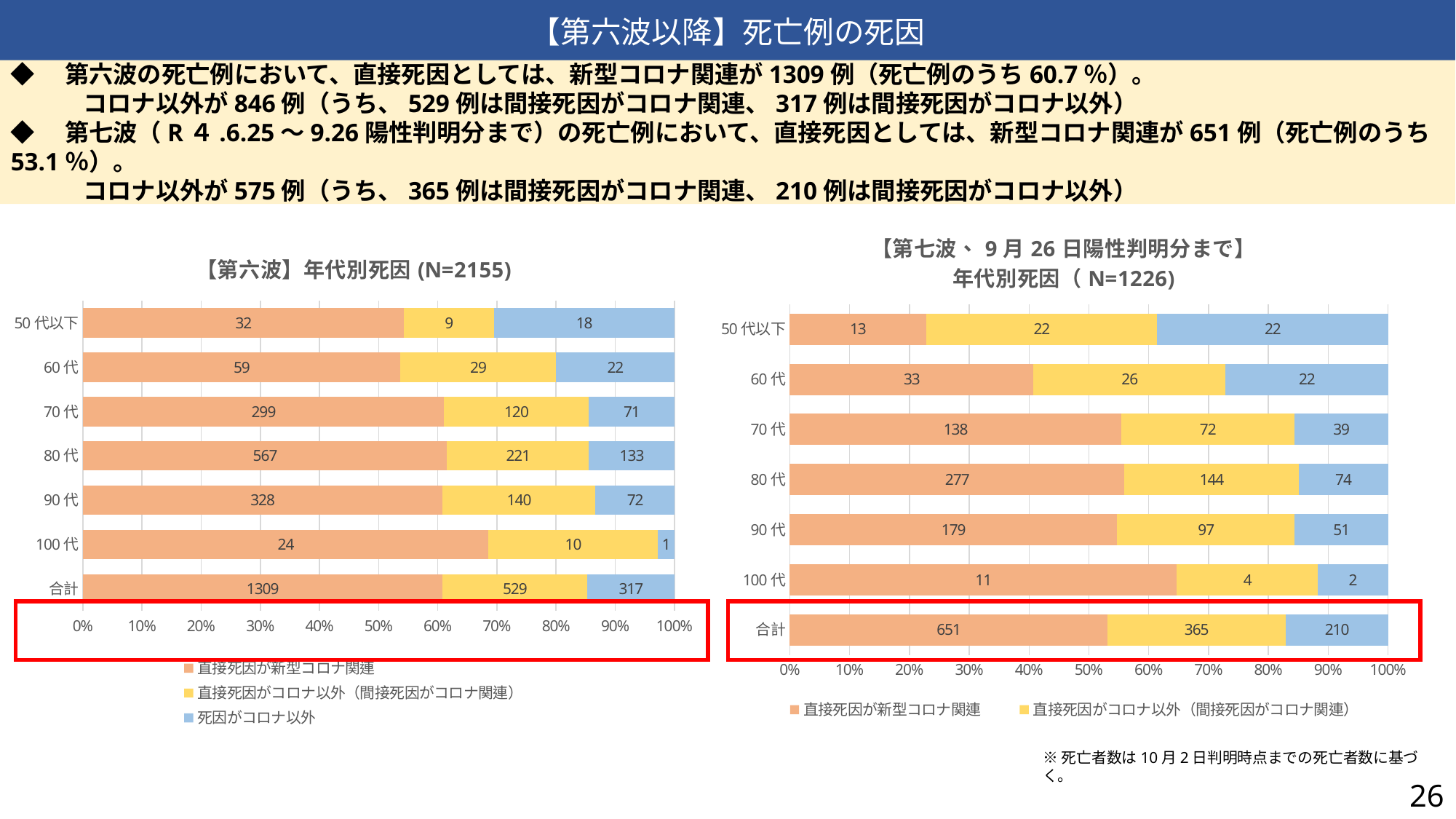
In the left chart (【第六波】年代別死因), how many series does the legend list? 3 In the left chart (【第六波】年代別死因), what is the value of 死因がコロナ以外 for 100代? 1 In the left chart (【第六波】年代別死因), which age group (excluding 合計) has the highest value for 直接死因が新型コロナ関連? 80代 In the left chart (【第六波】年代別死因), what is the value of 直接死因が新型コロナ関連 for 80代? 567 In the left chart (【第六波】年代別死因), what is the difference between the 直接死因が新型コロナ関連 values for 80代 and 90代? 239 What type of chart is the left chart (【第六波】年代別死因)? Stacked bar chart In the right chart (【第七波】年代別死因), what is the value of the middle (yellow) segment for 80代? 144 In the right chart (【第七波】年代別死因), what is the total of the three segments for the 合計 bar? 1226 In the right chart (【第七波】年代別死因), which is larger for 70代: the 直接死因が新型コロナ関連 value or the yellow segment value? 直接死因が新型コロナ関連 (138) In the right chart (【第七波】年代別死因), what is the value of 直接死因が新型コロナ関連 for 90代? 179 In the right chart (【第七波】年代別死因), which age group (excluding 合計) has the lowest value for 直接死因が新型コロナ関連? 100代 In the right chart (【第七波】年代別死因), how many categories are shown on the vertical axis, including 合計? 7